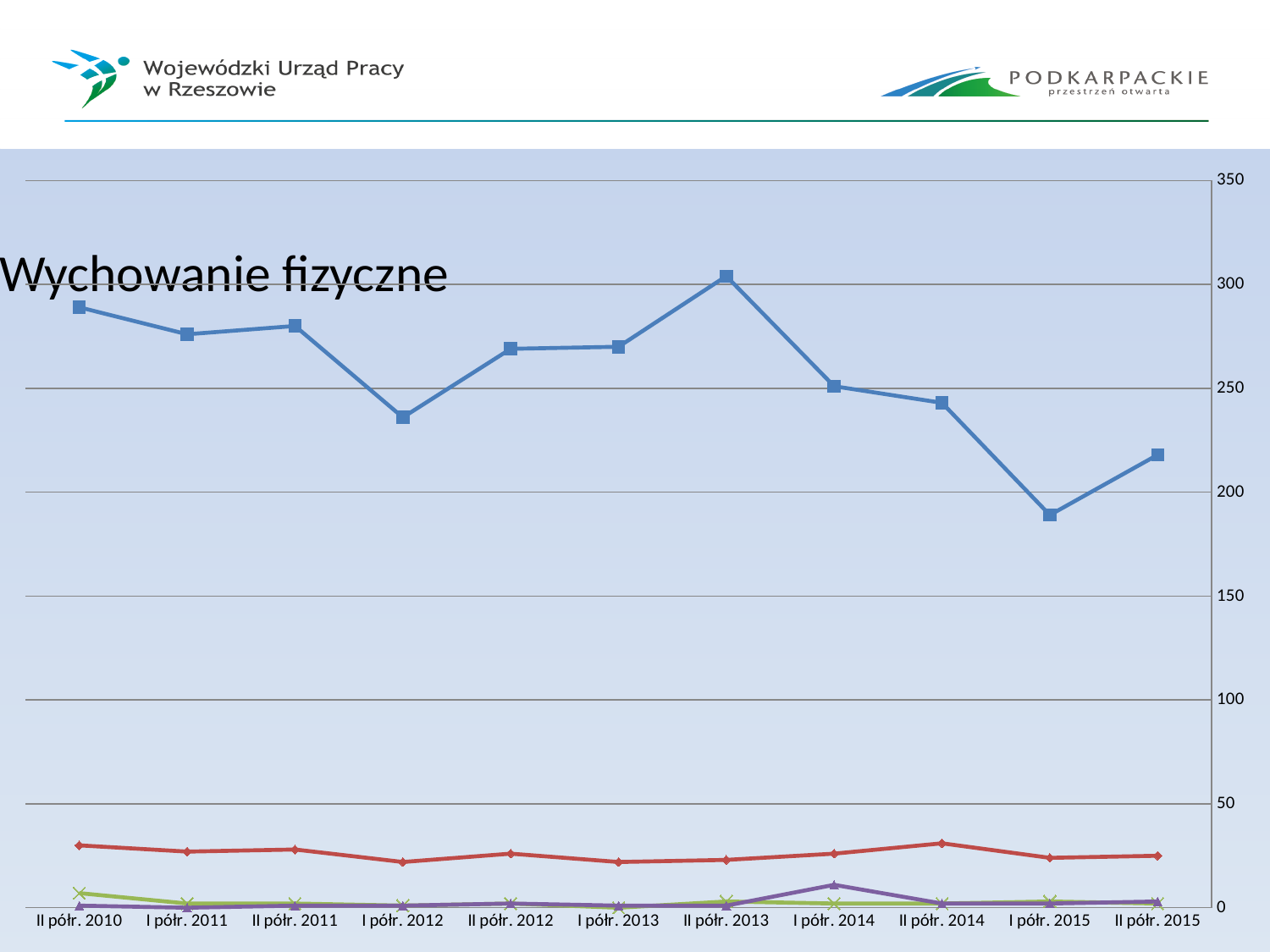
How many lines are plotted on the chart? 4 Is the value of the blue line for II półr. 2010 greater or less than 250? greater What is the title of the chart? Wychowanie fizyczne How many periods are shown along the x axis of the chart? 11 In which period does the blue line (square markers) reach its lowest value? I półr. 2015 Is the value of the blue line for I półr. 2012 greater or less than 250? less Does the blue line overall rise or fall from II półr. 2010 to II półr. 2015? fall Is the value of the blue line for II półr. 2013 greater or less than 300? greater In which period does the blue line (square markers) reach its highest value? II półr. 2013 For the blue line, which period has the larger value: II półr. 2010 or I półr. 2012? II półr. 2010 What kind of chart is shown on the slide? line chart